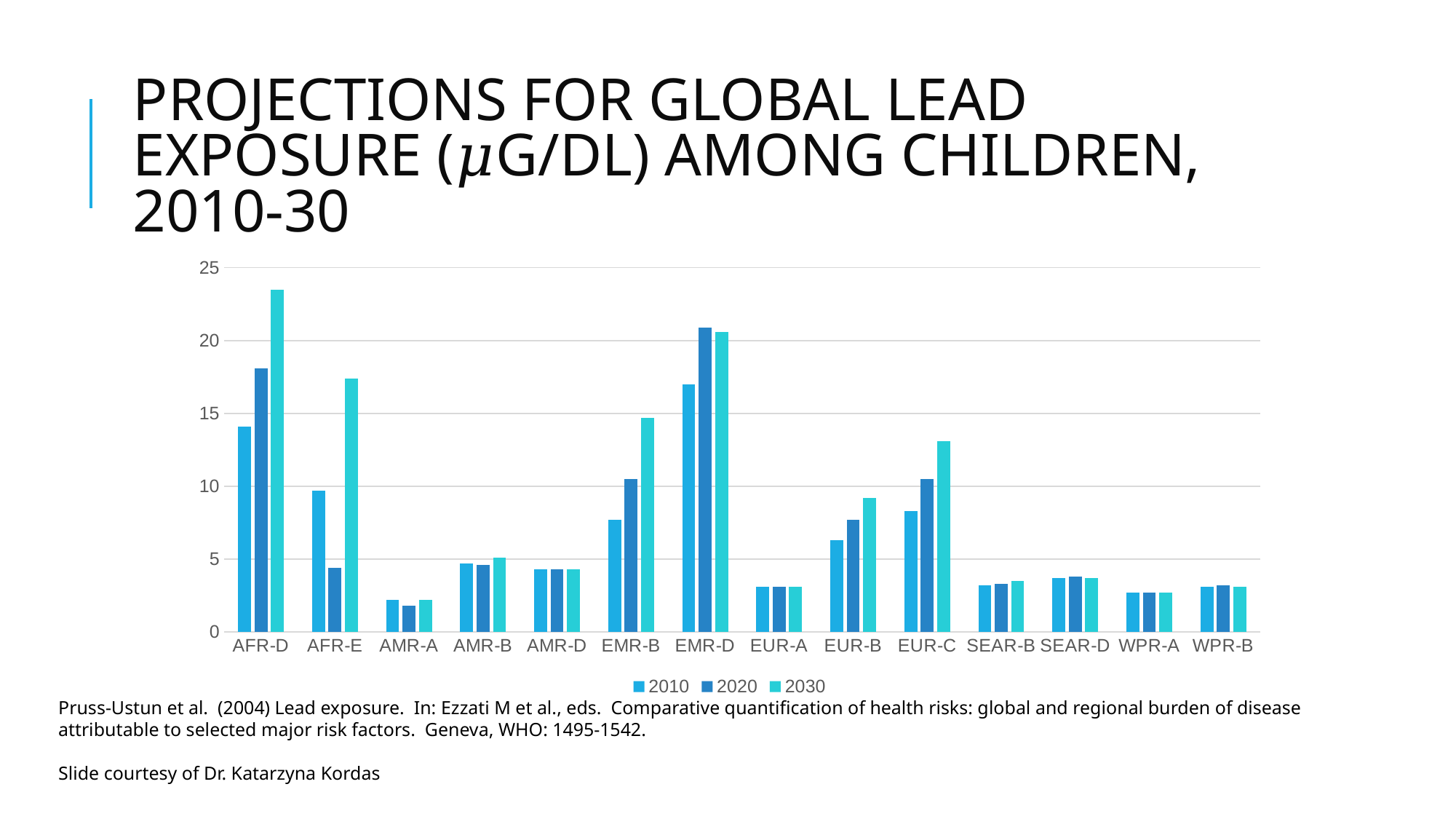
Which region has the highest 2010 value? EMR-D Is the 2030 value for EUR-C greater or less than 10? greater Which region has the lowest 2020 value? AMR-A How many series does the legend list? 3 Is the 2030 value for AFR-D greater or less than 20? greater Which is larger for AFR-E: the 2010 value or the 2020 value? 2010 Do the values for AFR-D rise or fall from 2010 to 2030? rise Is the 2020 value for AFR-E greater or less than 5? less What are the three years listed in the legend? 2010, 2020, 2030 How many regions (categories) are shown on the x axis? 14 Which region has the highest 2030 value? AFR-D What kind of chart is shown on the slide? bar chart